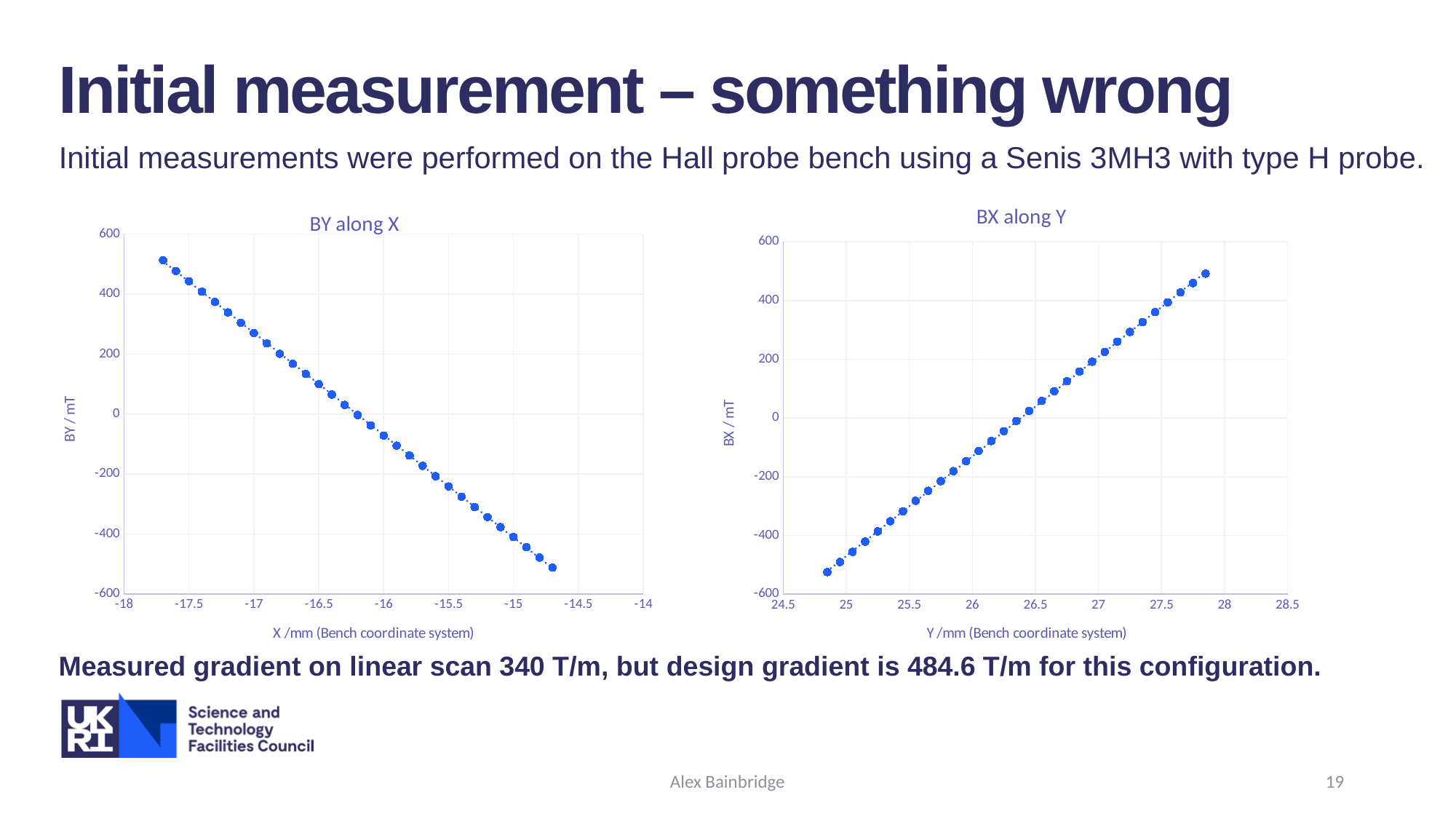
What is the y-axis label of the 'BX along Y' chart? BX / mT In the 'BX along Y' chart, is the value at Y = 25 mm greater or less than -400? less What kind of chart is 'BX along Y'? scatter chart What is the x-axis label of the 'BY along X' chart? X /mm (Bench coordinate system) In the 'BY along X' chart, is the value at X = -17.5 mm greater or less than 400? greater In the 'BY along X' chart, is the value at X = -17 mm greater or less than 200? greater In the 'BX along Y' chart, do the values rise or fall as Y increases? rise What kind of chart is 'BY along X'? scatter chart In the 'BY along X' chart, do the values rise or fall as X increases? fall